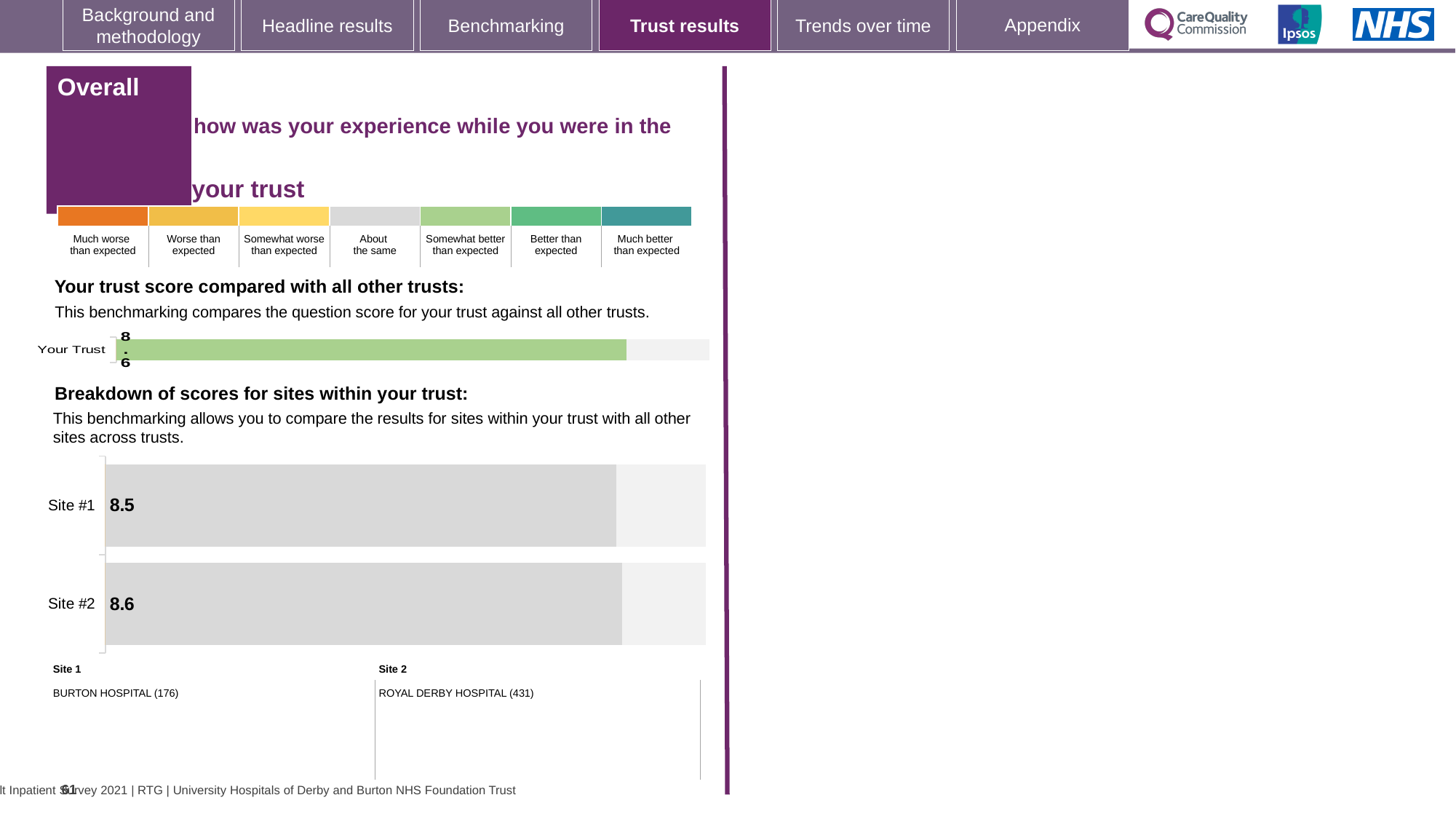
In the 'Breakdown of scores for sites within your trust' chart, what is the score for Site #1? 8.5 In the 'Breakdown of scores for sites within your trust' chart, is the score for Site #1 larger or smaller than the score for Site #2? smaller According to the site key below the 'Breakdown of scores for sites within your trust' chart, which hospital is Site 2? ROYAL DERBY HOSPITAL (431) In the 'Breakdown of scores for sites within your trust' chart, which site has the higher score? Site #2 In the 'Your trust score compared with all other trusts' chart, what is the score for Your Trust? 8.6 In the 'Breakdown of scores for sites within your trust' chart, which site has the lower score? Site #1 In the 'Breakdown of scores for sites within your trust' chart, what is the difference between the scores of Site #2 and Site #1? 0.1 What kind of chart is the 'Breakdown of scores for sites within your trust' chart? bar chart In the 'Breakdown of scores for sites within your trust' chart, what is the score for Site #2? 8.6 How many sites are shown in the 'Breakdown of scores for sites within your trust' chart? 2 How many bars are in the 'Your trust score compared with all other trusts' chart? 1 What kind of chart is the 'Your trust score compared with all other trusts' chart? bar chart